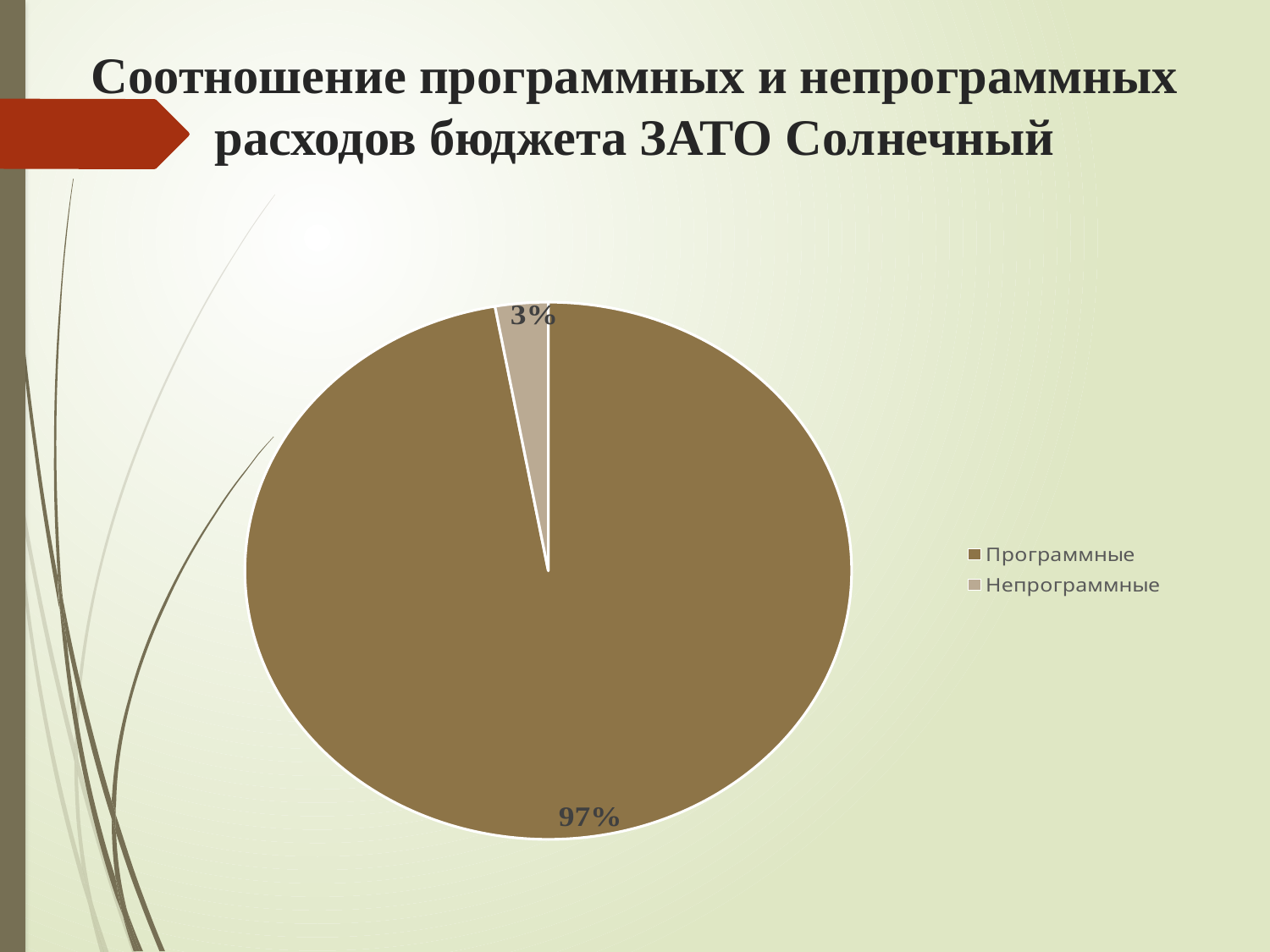
Which category has the largest slice of the pie? Программные Which legend entry is shown in the darker brown colour? Программные How many slices does the pie chart have? 2 Which is larger, the share for Программные or the share for Непрограммные? Программные What is the title of the slide? Соотношение программных и непрограммных расходов бюджета ЗАТО Солнечный Which category has the smallest slice of the pie? Непрограммные What is the difference in percentage points between Программные and Непрограммные? 94 What share of the pie does Программные take? 97% What kind of chart is shown on the slide? pie chart What share of the pie does Непрограммные take? 3% How many entries does the legend list? 2